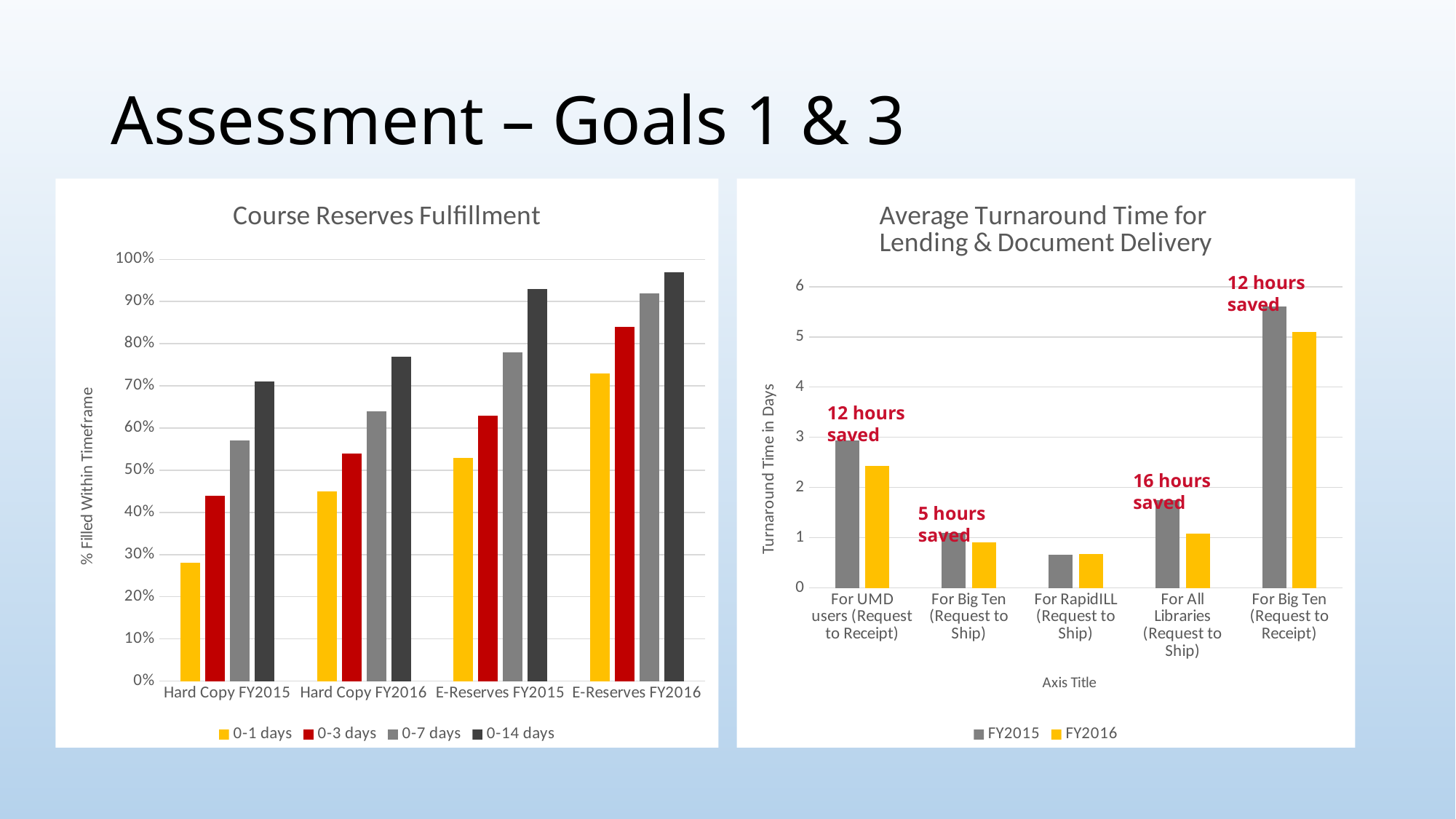
What kind of chart is the 'Course Reserves Fulfillment' chart? bar chart In the 'Course Reserves Fulfillment' chart, is the 0-14 days value for E-Reserves FY2016 greater or less than 90%? greater In the 'Average Turnaround Time for Lending & Document Delivery' chart, which is larger for 'For All Libraries (Request to Ship)': FY2015 or FY2016? FY2015 How many series does the legend of the 'Average Turnaround Time for Lending & Document Delivery' chart list? 2 How many categories are shown on the x axis of the 'Average Turnaround Time for Lending & Document Delivery' chart? 5 In the 'Course Reserves Fulfillment' chart, which category and series has the lowest bar? 0-1 days, Hard Copy FY2015 In the 'Average Turnaround Time for Lending & Document Delivery' chart, which category has the highest FY2015 bar? For Big Ten (Request to Receipt) In the 'Course Reserves Fulfillment' chart, which is larger: the 0-1 days value for E-Reserves FY2015 or for E-Reserves FY2016? E-Reserves FY2016 How many series does the legend of the 'Course Reserves Fulfillment' chart list? 4 In the 'Course Reserves Fulfillment' chart, which category and series has the highest bar? 0-14 days, E-Reserves FY2016 How many categories are shown on the x axis of the 'Course Reserves Fulfillment' chart? 4 In the 'Course Reserves Fulfillment' chart, is the 0-1 days value for Hard Copy FY2015 greater or less than 40%? less